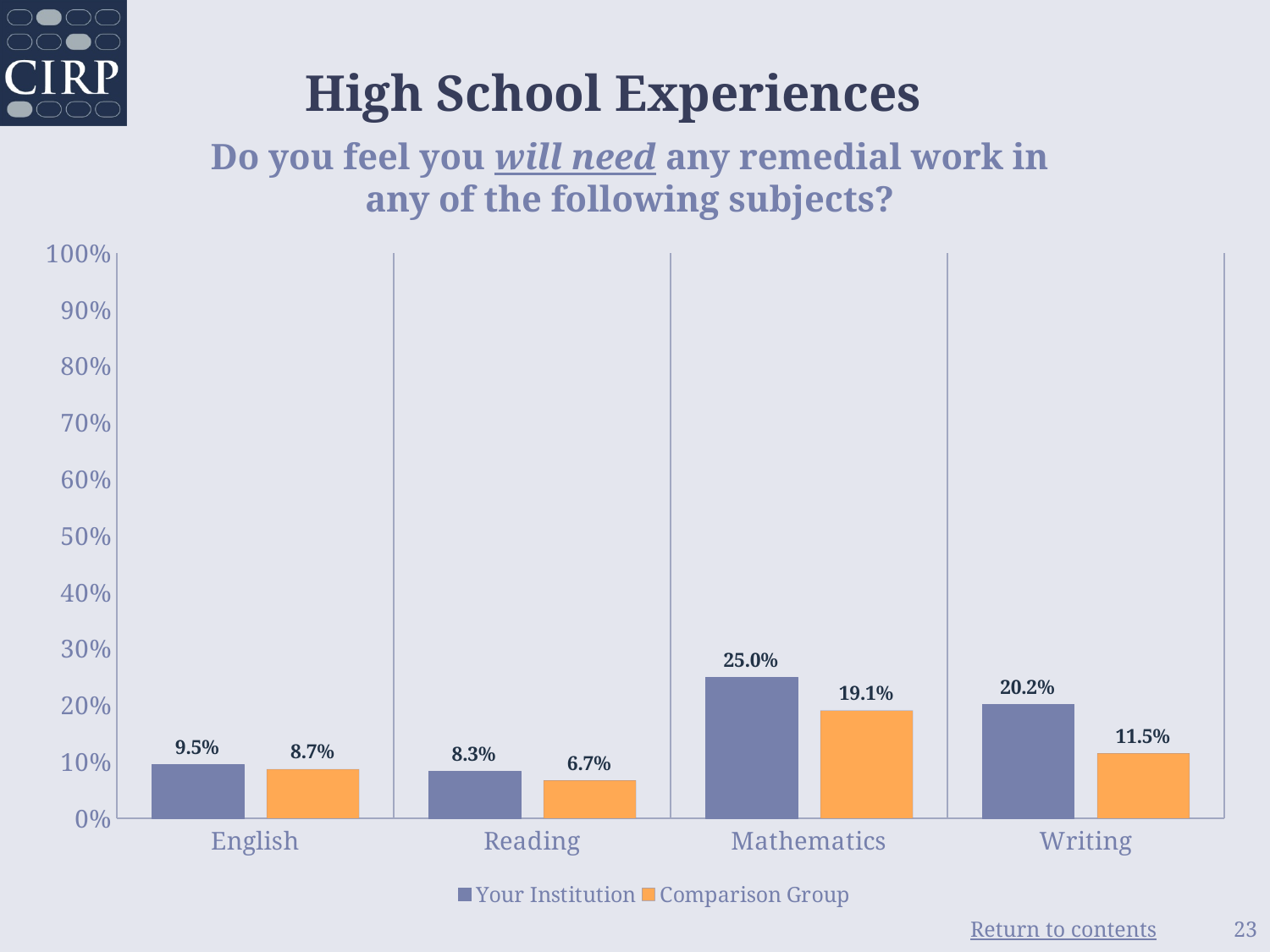
What kind of chart is shown on the slide? Bar chart What is the value for Your Institution in Reading? 8.3% What is the value for Comparison Group in Writing? 11.5% Which subject has the lowest value for Comparison Group? Reading Which is larger in Mathematics: Your Institution or Comparison Group? Your Institution What is the value for Comparison Group in English? 8.7% How many subjects are shown on the x axis? 4 Is the value for Your Institution in Writing greater or less than 30%? less What is the value for Your Institution in Mathematics? 25.0% How many series does the legend list? 2 What is the difference between Your Institution and Comparison Group in Writing? 8.7% Which subject has the highest value for Your Institution? Mathematics